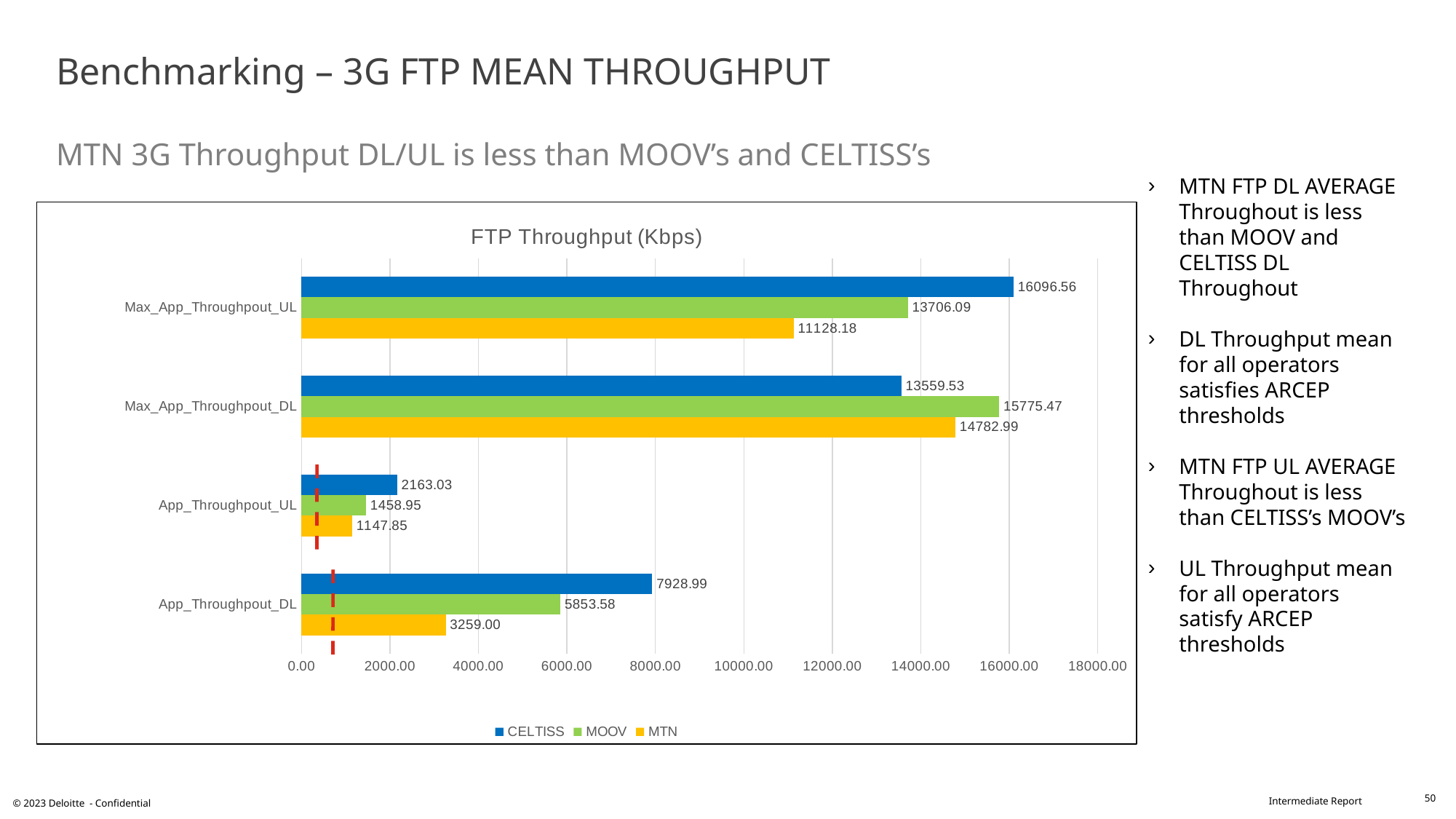
What is the MTN value for App_Throughput_DL? 3259.00 What is the difference between the CELTISS and MTN values for App_Throughput_DL? 4669.99 Which operator has the highest value for App_Throughput_UL? CELTISS What is the MOOV value for Max_App_Throughpout_DL? 15775.47 What is the title of the chart? FTP Throughput (Kbps) Is the MOOV value for App_Throughput_DL greater or less than 6000.00? less What is the CELTISS value for Max_App_Throughpout_UL? 16096.56 How many series does the legend list? 3 What kind of chart is shown on the slide? Bar chart Which is larger for Max_App_Throughpout_UL: the MOOV value or the MTN value? MOOV How many categories are shown on the y axis of the chart? 4 Which operator has the lowest value for Max_App_Throughpout_DL? CELTISS